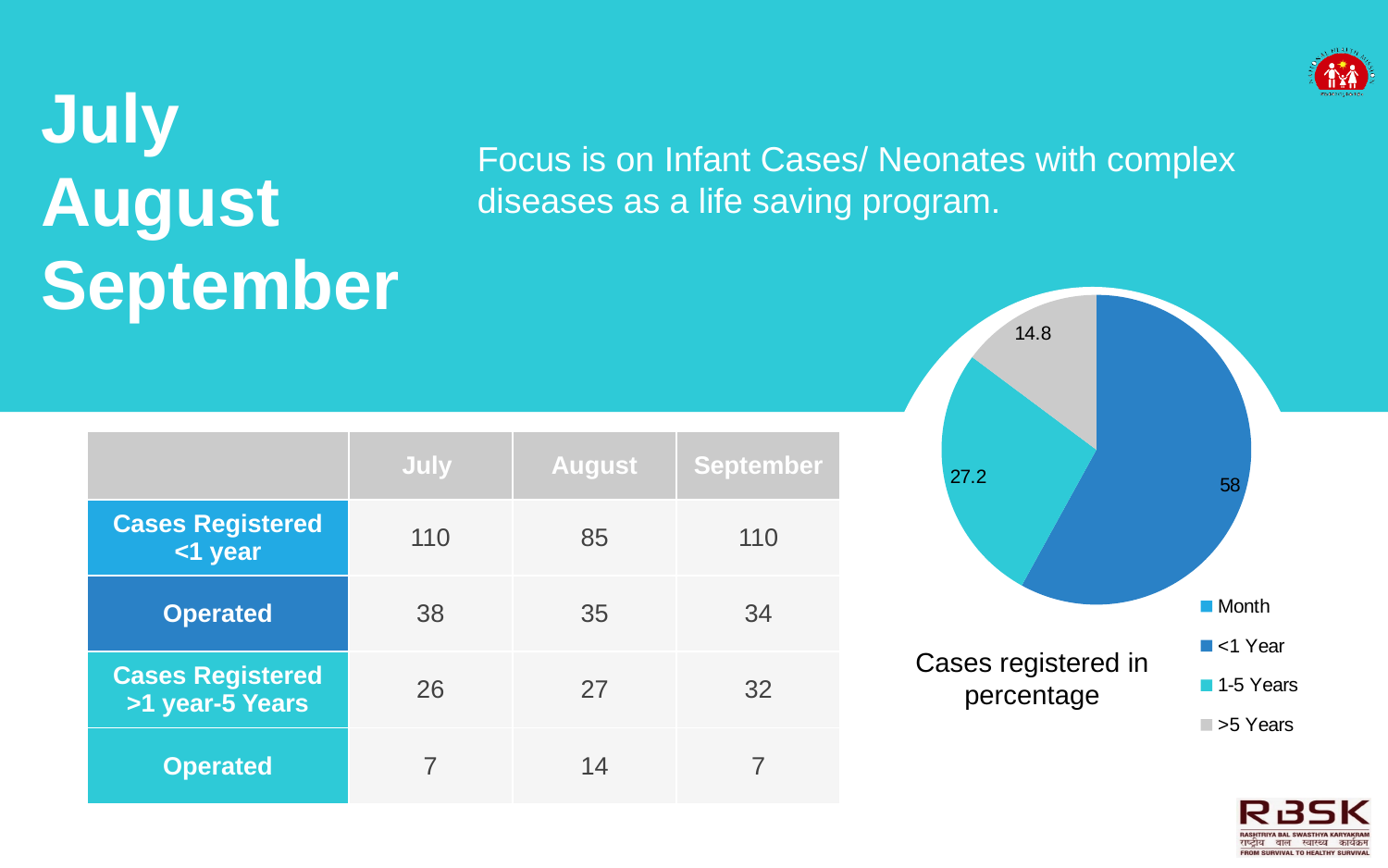
How many slices are shown in the pie chart? 3 What is the difference between the <1 Year and 1-5 Years values in the pie chart? 30.8 Which slice of the pie chart is the largest? <1 Year What is the difference between the 1-5 Years and >5 Years values in the pie chart? 12.4 How many entries does the pie chart's legend list? 4 What value is shown for the >5 Years slice of the pie chart? 14.8 Which is larger in the pie chart, the 1-5 Years slice or the >5 Years slice? 1-5 Years What value is shown for the <1 Year slice of the pie chart? 58 What value is shown for the 1-5 Years slice of the pie chart? 27.2 What type of chart is shown on the slide? pie chart What is the title of the pie chart? Cases registered in percentage Which slice of the pie chart is the smallest? >5 Years